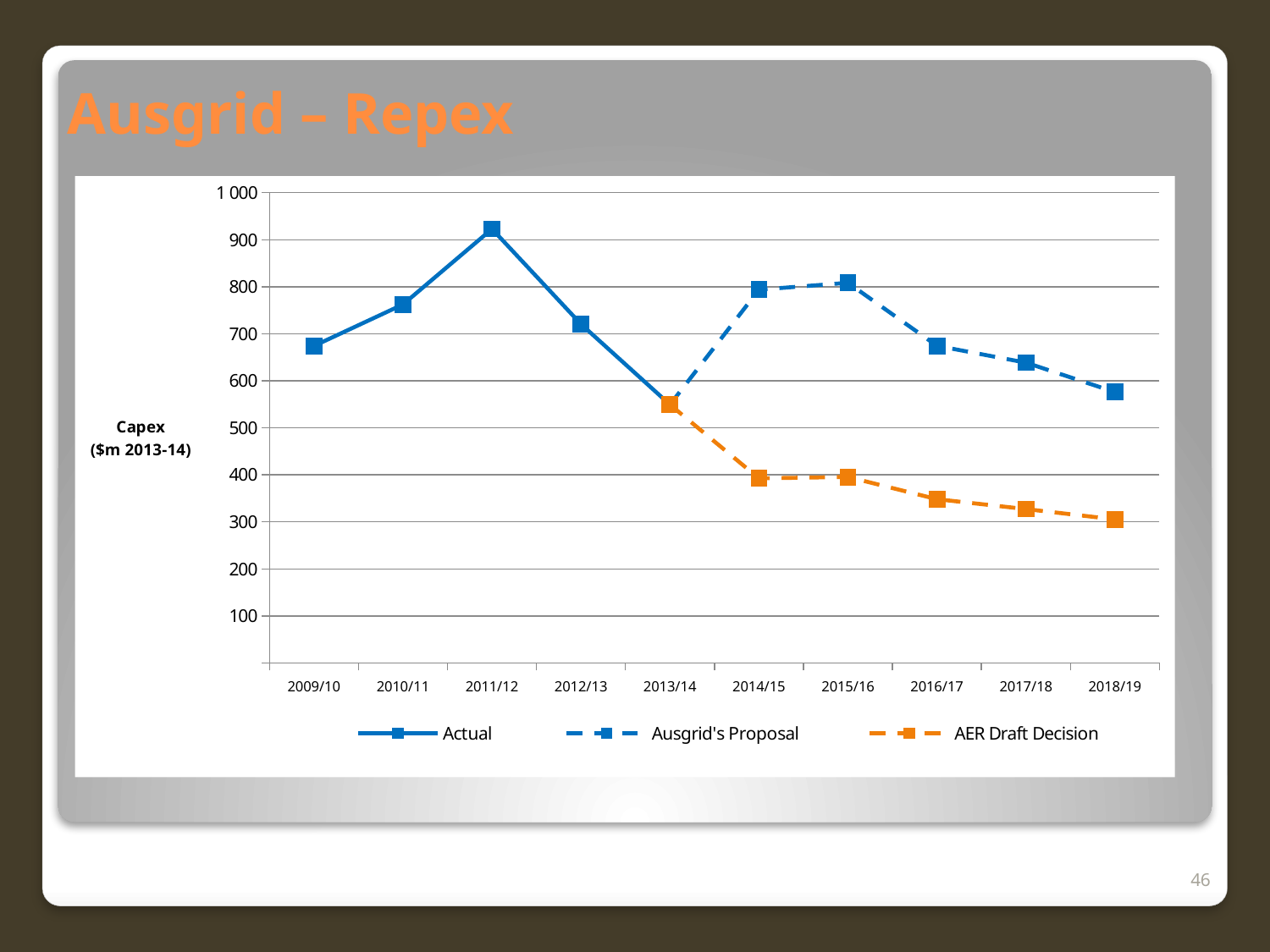
In 2018/19, which is larger: Ausgrid's Proposal or the AER Draft Decision? Ausgrid's Proposal In which year is the AER Draft Decision series at its lowest value? 2018/19 Is the Actual value for 2011/12 greater or less than 900? greater How many series does the legend list? 3 Is the Ausgrid's Proposal value for 2016/17 greater or less than 600? greater Is the Actual value for 2009/10 greater or less than 700? less Does the AER Draft Decision series rise or fall from 2014/15 to 2018/19? fall In which year does the Actual series reach its highest value? 2011/12 What is the label on the vertical axis of the chart? Capex ($m 2013-14) How many years are shown along the x axis? 10 What kind of chart is shown on the slide? line chart